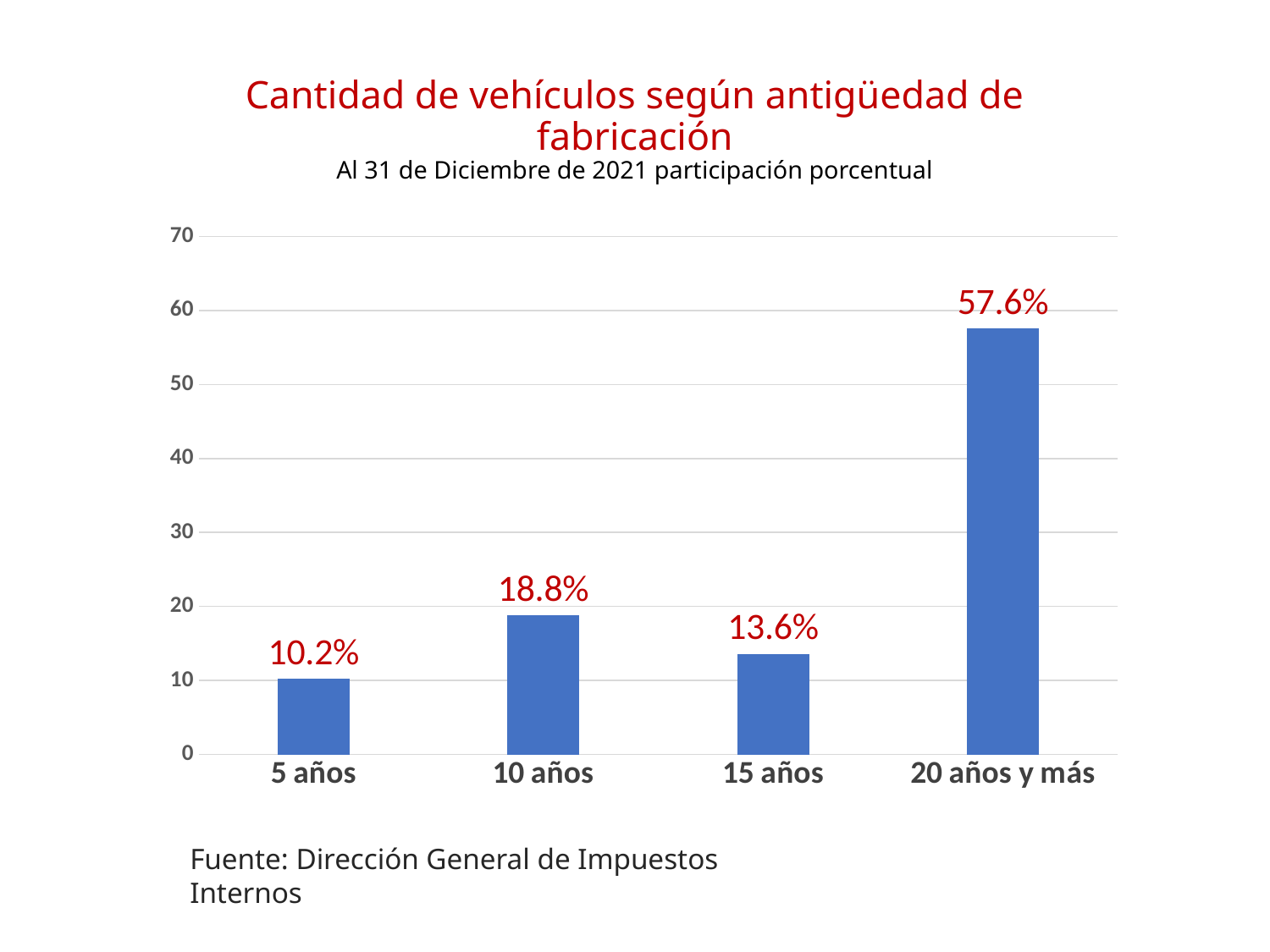
What is the difference between the values for 20 años y más and 10 años? 38.8% Which category has the highest value? 20 años y más Which is larger, the value for 10 años or the value for 15 años? 10 años What is the title of the chart? Cantidad de vehículos según antigüedad de fabricación What is the value for 10 años? 18.8% What kind of chart is shown on the slide? bar chart What is the value for 15 años? 13.6% How many categories are shown on the x axis? 4 Which category has the lowest value? 5 años What is the value for 20 años y más? 57.6% Is the value for 20 años y más greater or less than 50? greater What is the value for 5 años? 10.2%